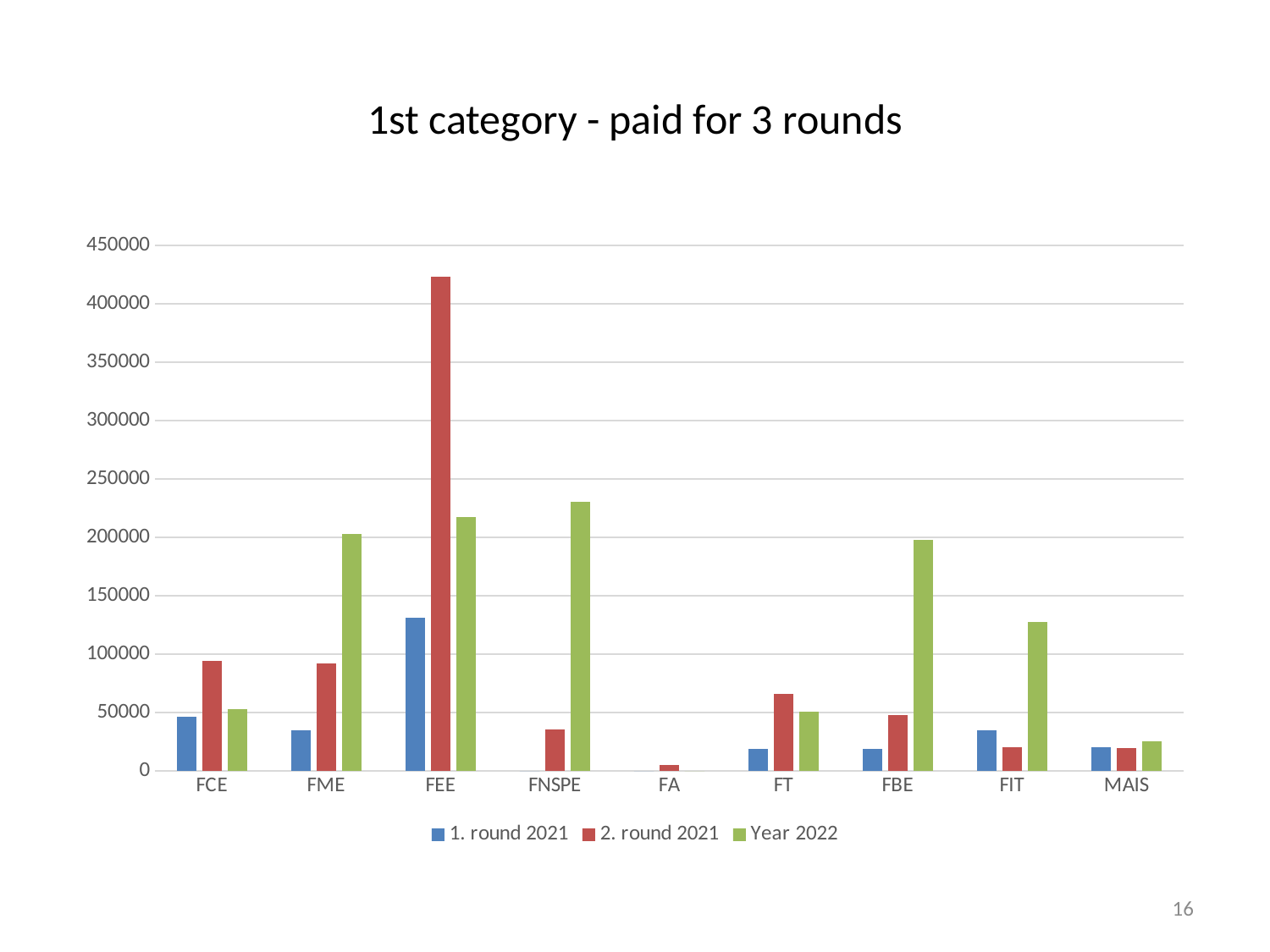
What colour represents the Year 2022 series? green Is the value for 2. round 2021 at FEE greater or less than 400000? greater Which category has the highest value for Year 2022? FNSPE What kind of chart is shown on the slide? bar chart How many categories are shown on the x axis? 9 What is the title of the chart? 1st category - paid for 3 rounds Which category has the highest value for 1. round 2021? FEE For FCE, which is larger: 2. round 2021 or Year 2022? 2. round 2021 Which category has the highest value for 2. round 2021? FEE How many series does the legend list? 3 Is the value for 1. round 2021 at FCE greater or less than 50000? less Is the value for Year 2022 at FIT greater or less than 100000? greater